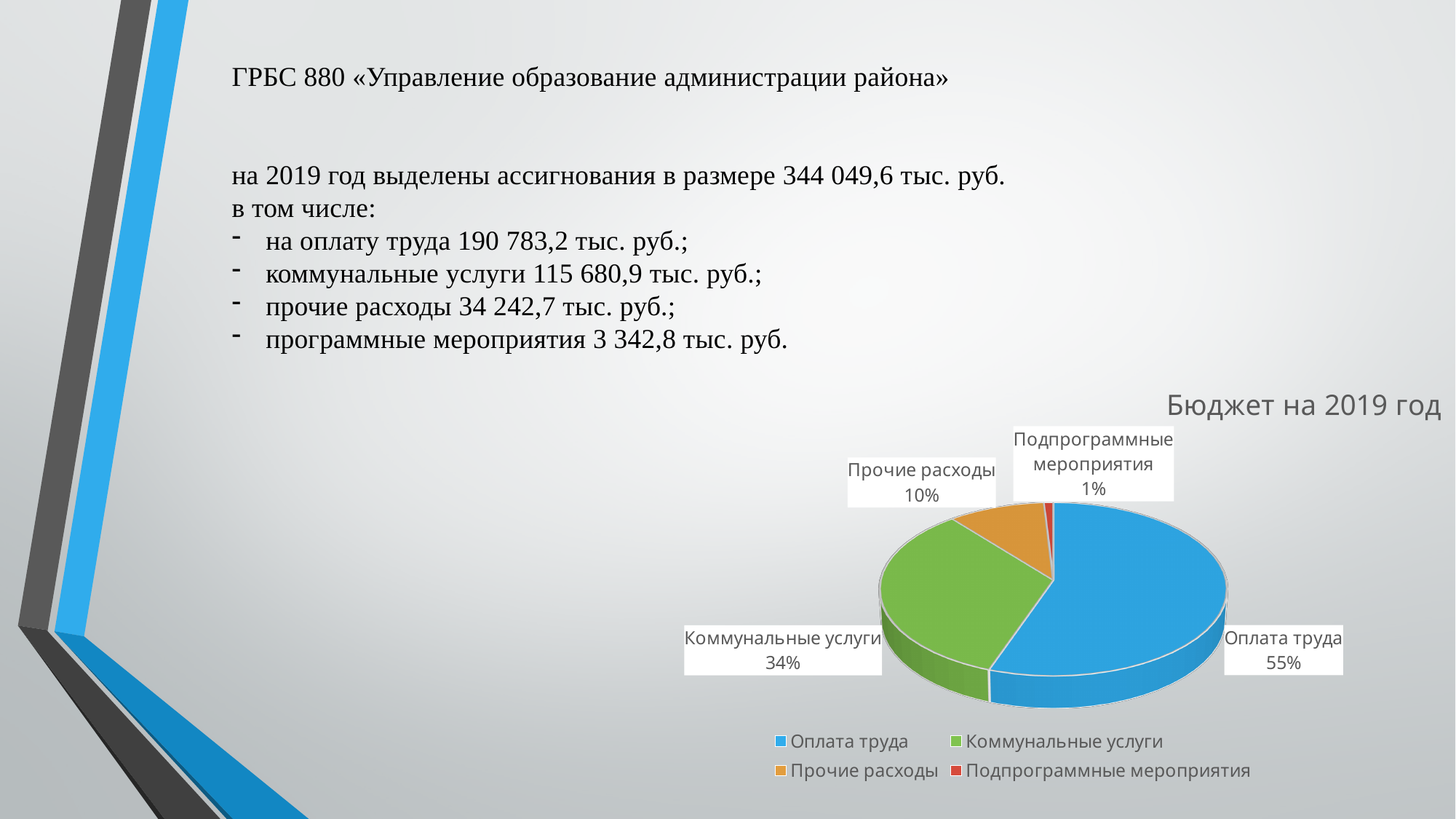
What share of the pie does Оплата труда take? 55% What colour is the slice for Прочие расходы? Orange Which category has the smallest slice of the pie? Подпрограммные мероприятия What is the difference in percentage points between Оплата труда and Коммунальные услуги? 21 What share of the pie does Коммунальные услуги take? 34% What share of the pie does Прочие расходы take? 10% What is the title of the chart? Бюджет на 2019 год Which is larger, the share for Коммунальные услуги or the share for Прочие расходы? Коммунальные услуги How many categories are shown in the pie chart? 4 What type of chart is shown on the slide? Pie chart Which category has the largest slice of the pie? Оплата труда